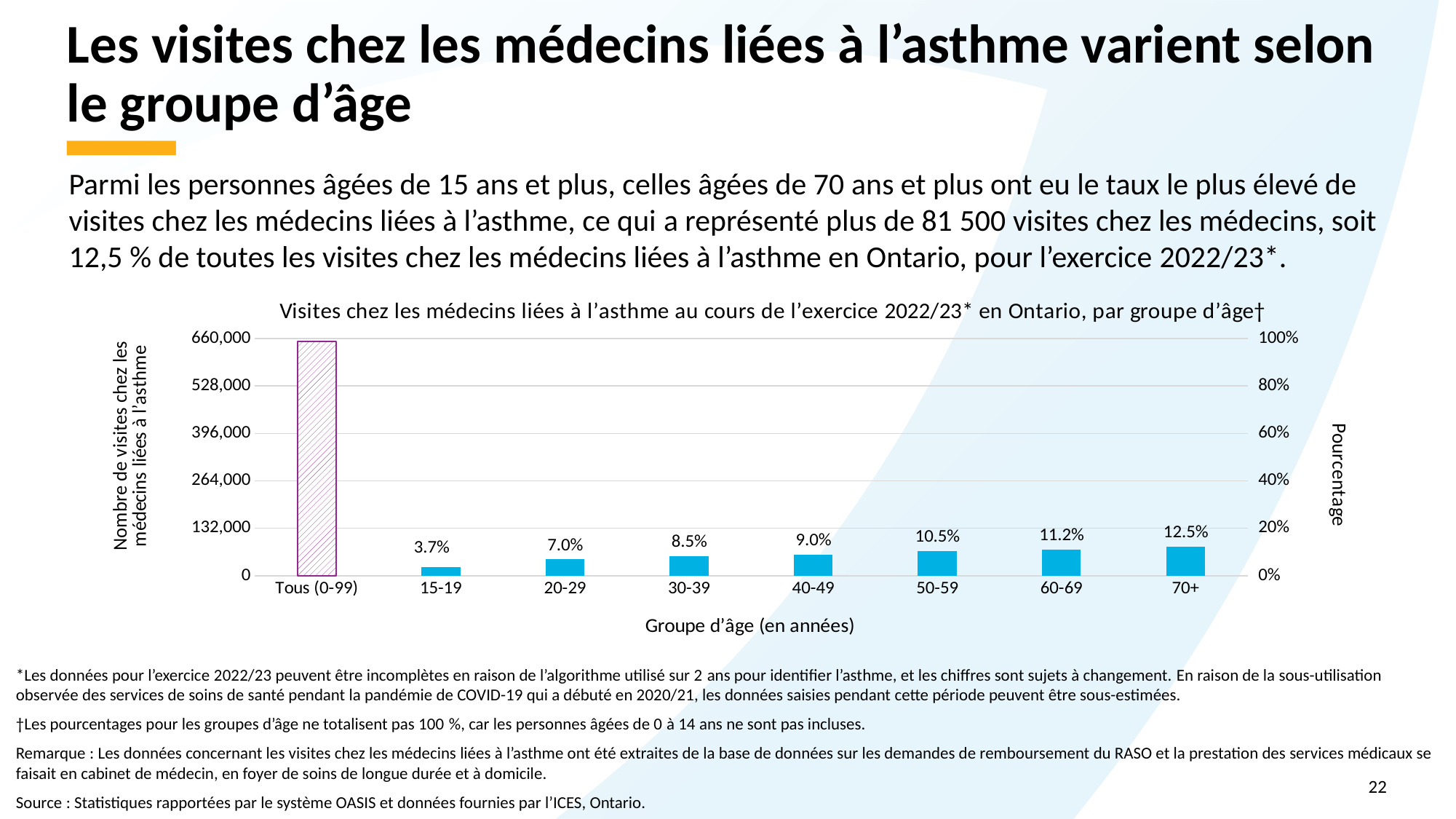
Among the age groups with percentage labels, which has the lowest percentage? 15-19 What percentage is shown for the 40-49 age group? 9.0% What percentage of asthma-related physician visits is shown for the 70+ age group? 12.5% Do the percentages rise or fall as the age groups increase from 15-19 to 70+? rise Is the number of visits for the Tous (0-99) bar greater or less than 528,000? greater What percentage is shown for the 15-19 age group? 3.7% How many age-group categories are shown on the x axis, including Tous (0-99)? 8 What type of chart is shown on the slide? bar chart Among the age groups with percentage labels, which has the highest percentage? 70+ What is the difference in percentage points between the 70+ group and the 15-19 group? 8.8 What is the difference in percentage points between the 60-69 group and the 50-59 group? 0.7 Which has a higher percentage, the 20-29 group or the 30-39 group? 30-39